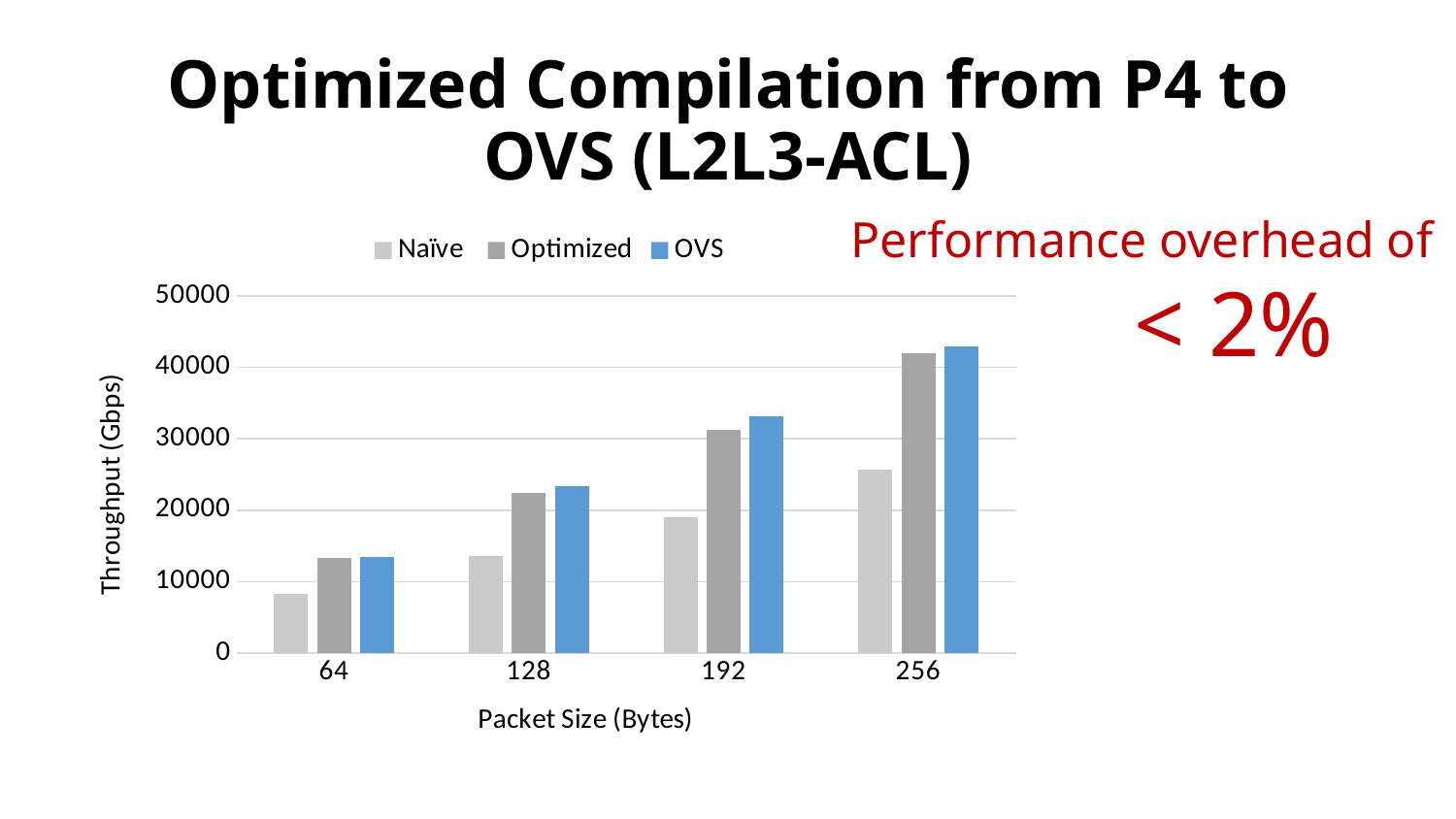
At packet size 256, which is larger: the Naïve throughput or the OVS throughput? OVS Which packet size has the lowest Naïve throughput? 64 What is the label of the y axis? Throughput (Gbps) Does the Optimized throughput rise or fall as packet size increases along the x axis? rise Is the OVS throughput at packet size 256 greater or less than 40000? greater How many series does the legend list? 3 Which packet size has the highest OVS throughput? 256 How many packet size categories are shown on the x axis? 4 Is the Naïve throughput at packet size 64 greater or less than 10000? less What kind of chart is shown on the slide? bar chart Is the Optimized throughput at packet size 128 greater or less than 20000? greater